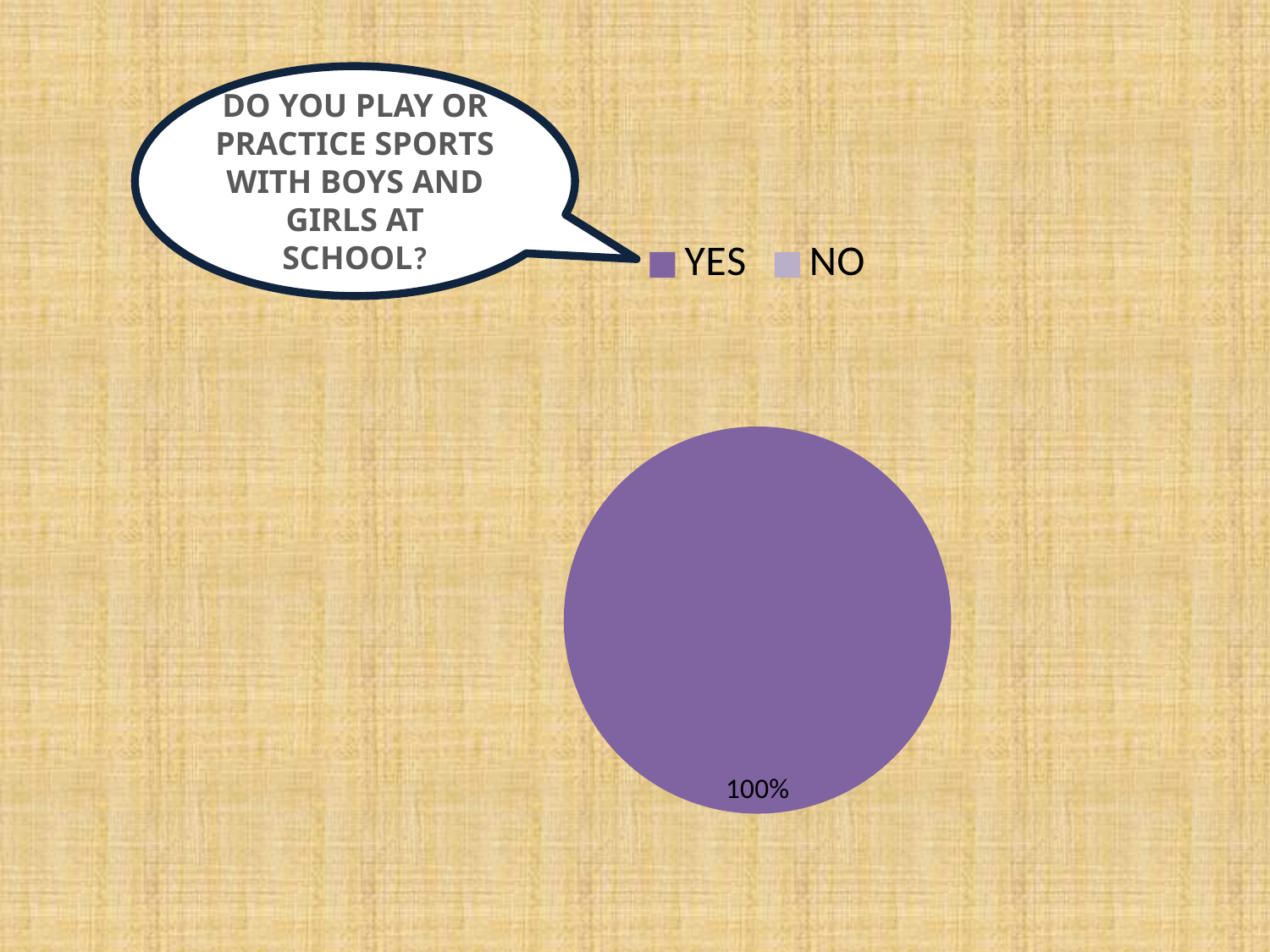
What colour is the YES slice in the pie chart? purple What percentage of the pie chart is labelled for YES? 100% Is the share for YES greater or less than 50%? greater What are the two legend entries of the chart? YES and NO Which is larger in the pie chart, YES or NO? YES Which category has the smallest share of the pie chart? NO What kind of chart is shown on the slide? pie chart How many entries does the legend list? 2 Which category has the largest share of the pie chart? YES What share of the pie does the YES slice take? 100%